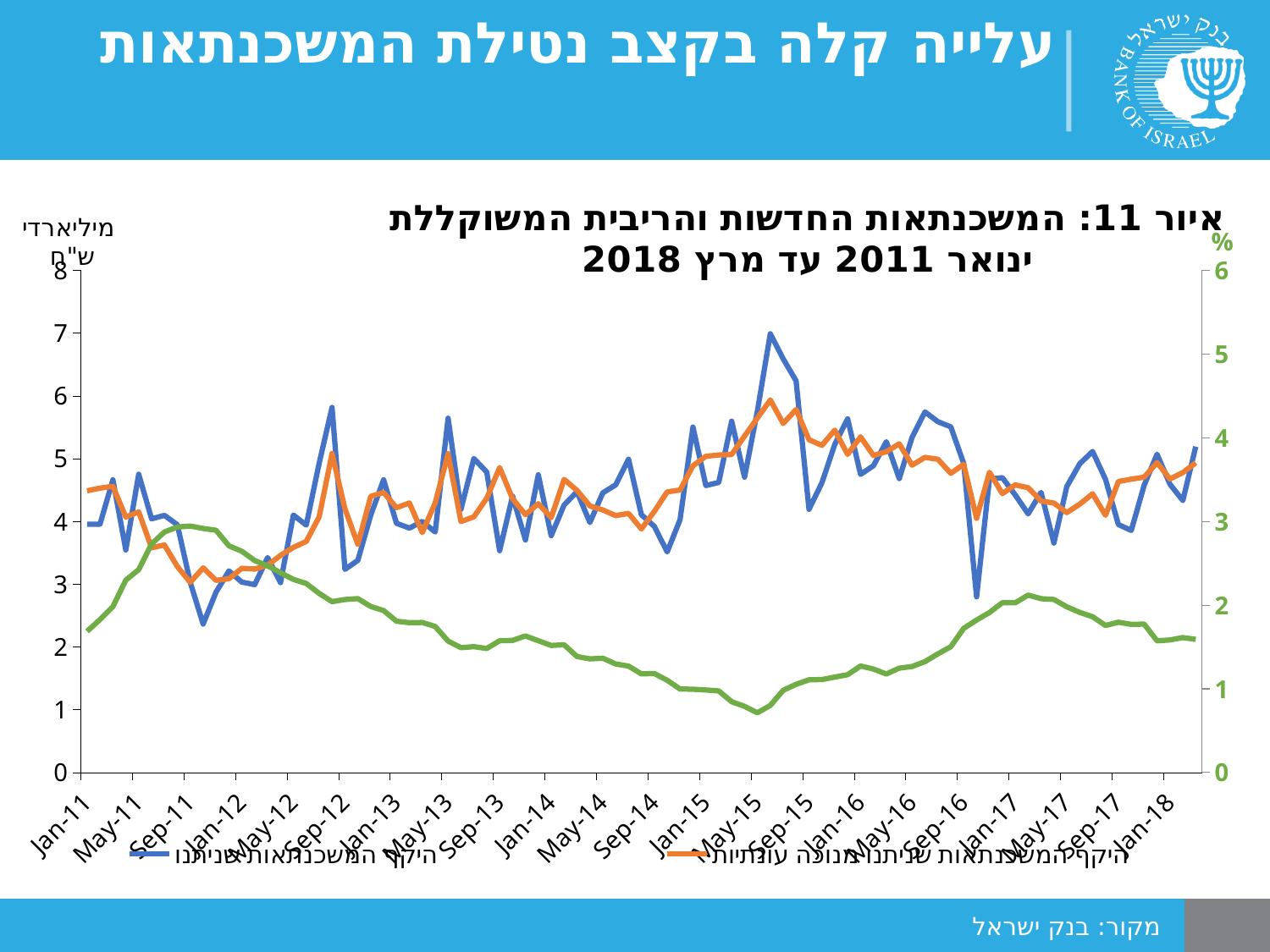
What kind of chart is shown on the slide? line chart Does the green line rise or fall between Sep-11 and May-15? fall What is the unit shown on the right vertical axis? % What is the maximum value shown on the right vertical axis? 6 What is the last x-axis label on the chart? Jan-18 Around which year does the blue line reach its highest peak? 2015 Does the green line rise or fall between May-15 and May-17? rise How many lines are plotted on the chart? 3 What is the unit shown on the left vertical axis? מיליארדי ש"ח What is the first x-axis label on the chart? Jan-11 Is the peak value of the blue line (on the left axis) greater or less than 6? greater